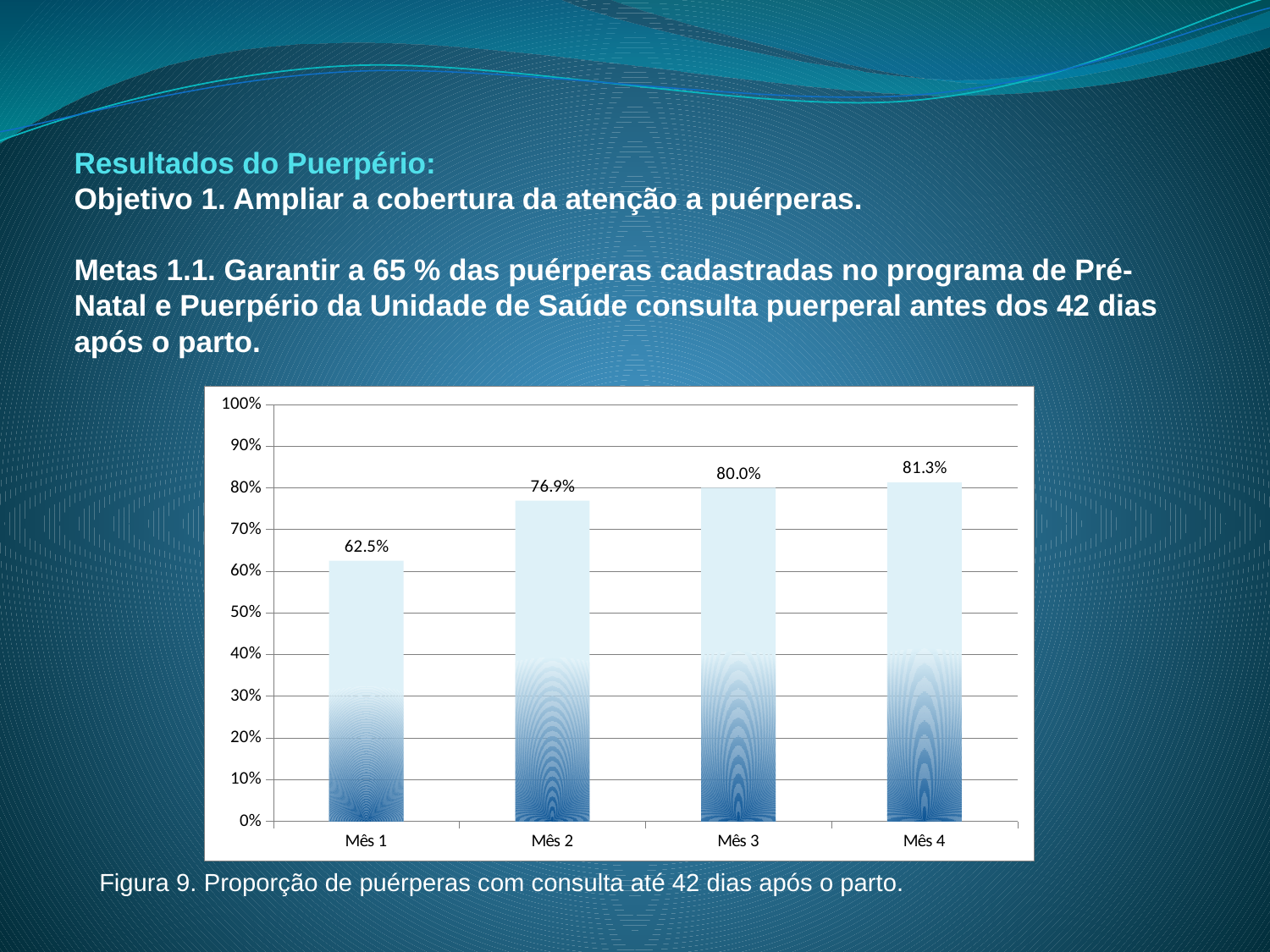
Is the value for Mês 1 greater or less than 70%? less Do the values rise or fall from Mês 1 to Mês 4? rise What kind of chart is shown on the slide? bar chart What is the value for Mês 4? 81.3% Which month has the lowest value? Mês 1 How many months are shown on the x axis? 4 Which month has the highest value? Mês 4 What is the caption given for the figure below the chart? Figura 9. Proporção de puérperas com consulta até 42 dias após o parto. Which is larger, the value for Mês 2 or the value for Mês 3? Mês 3 What is the value for Mês 1? 62.5% What is the value for Mês 3? 80.0% What is the difference between the values for Mês 2 and Mês 1? 14.4%